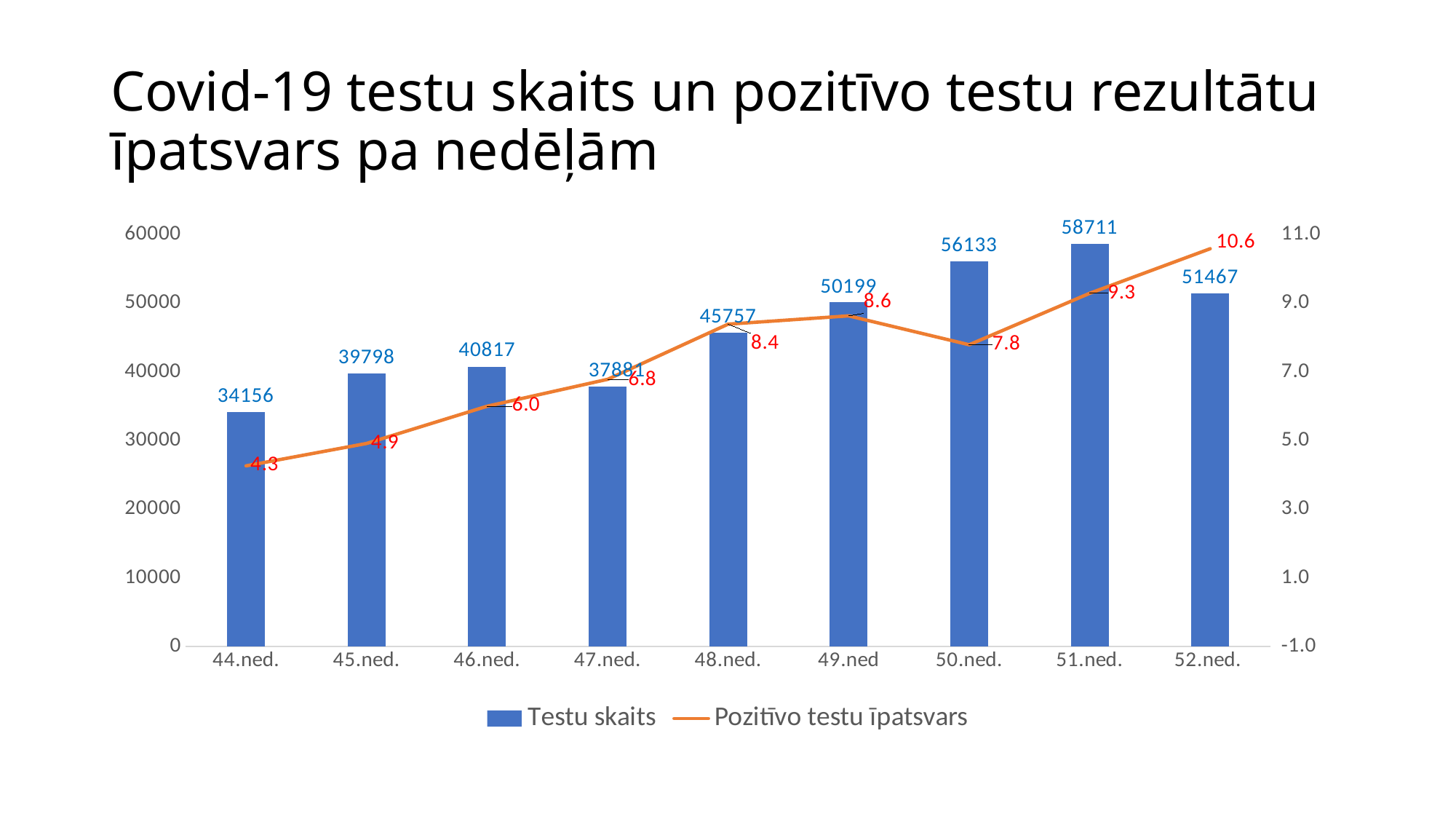
Which week has the lowest Pozitīvo testu īpatsvars? 44.ned. By how much does Pozitīvo testu īpatsvars in 52.ned. exceed that in 44.ned.? 6.3 What is the value of Testu skaits for 44.ned.? 34156 How many weeks are shown on the x axis? 9 Which week has the larger Testu skaits, 49.ned or 52.ned.? 52.ned. What is the Pozitīvo testu īpatsvars value for 50.ned.? 7.8 What is the difference in Testu skaits between 51.ned. and 50.ned.? 2578 What is the Pozitīvo testu īpatsvars value for 52.ned.? 10.6 What is the value of Testu skaits for 51.ned.? 58711 Which week has the highest Testu skaits? 51.ned. How many series does the legend list? 2 What kind of chart is shown on the slide? Combination bar and line chart